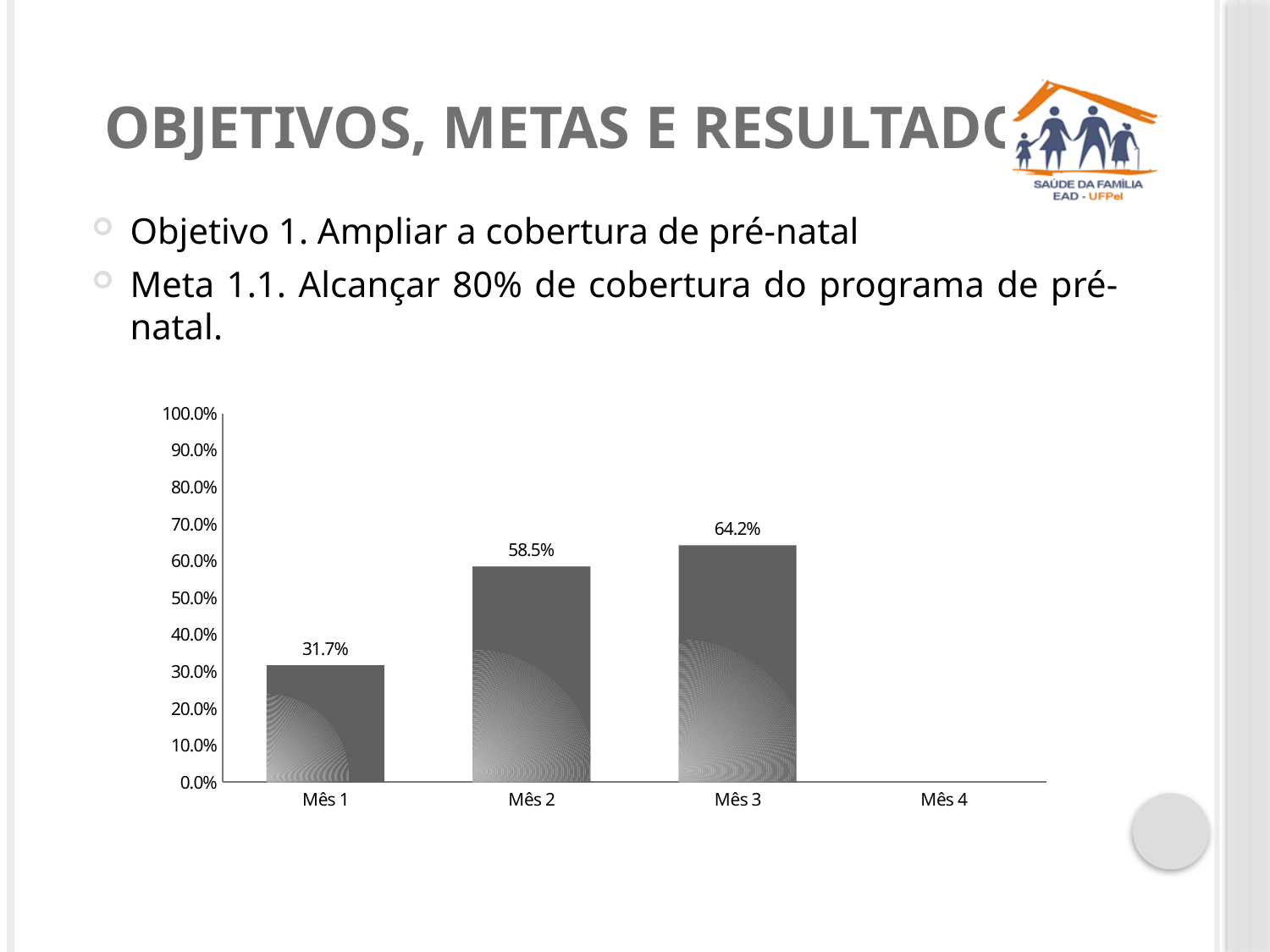
Which month with a plotted bar has the lowest value? Mês 1 What is the value for Mês 2? 58.5% What kind of chart is shown on the slide? bar chart How many categories are shown on the x axis? 4 What is the value for Mês 3? 64.2% What is the difference between the values for Mês 3 and Mês 1? 32.5% What is the value for Mês 1? 31.7% Which is larger, the value for Mês 2 or the value for Mês 3? Mês 3 Do the values rise or fall from Mês 1 to Mês 3? rise What is the difference between the values for Mês 2 and Mês 1? 26.8% Which month has the highest value shown? Mês 3 Is the value for Mês 3 greater or less than 80.0%? less